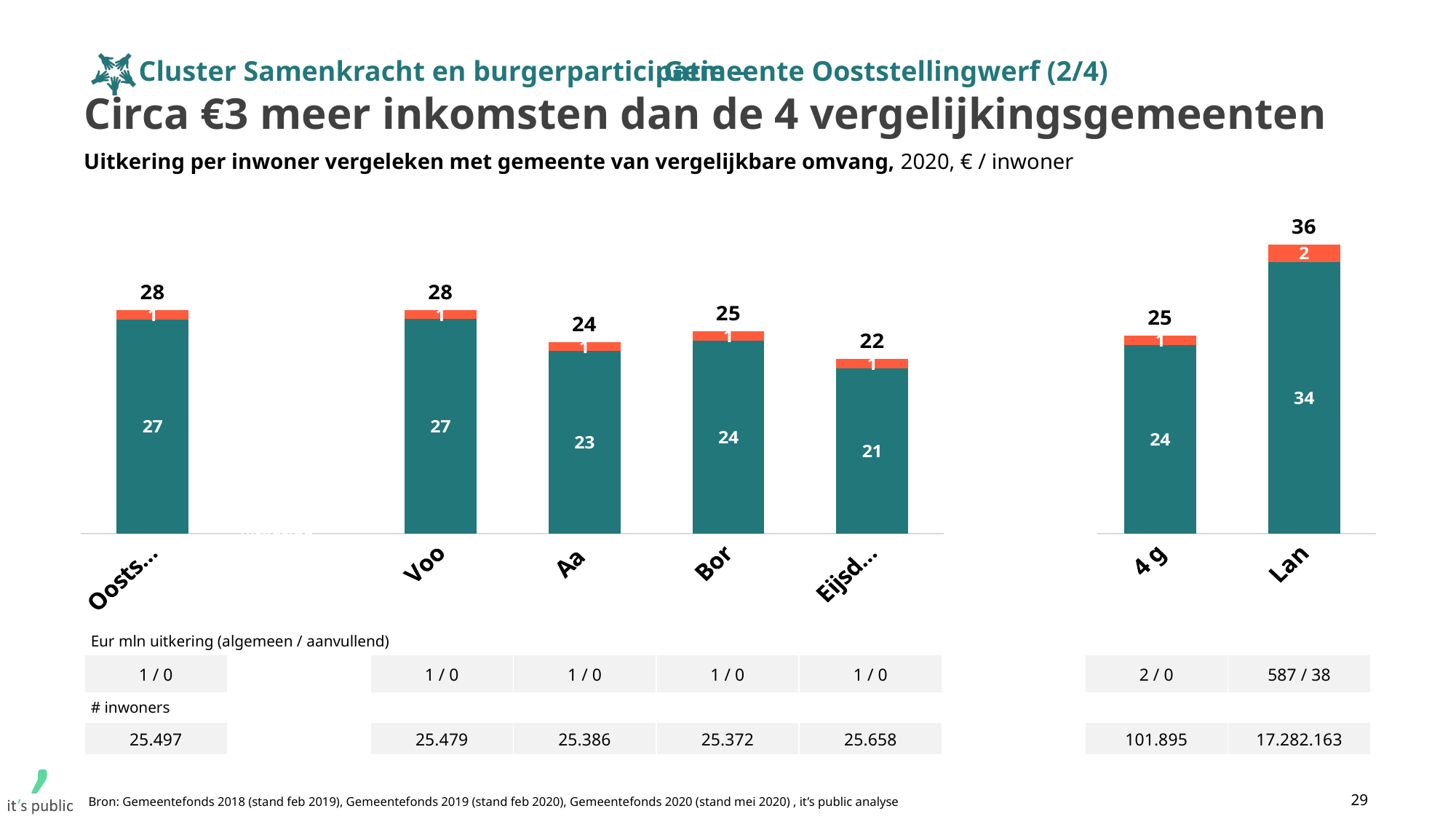
What is the total value shown above the bar for "Eijsd..."? 22 What kind of chart is shown on the slide? Stacked bar chart What is the total value shown above the bar for "Lan"? 36 Which category has the lowest total value? Eijsd... What is the difference between the total for "Lan" and the total for "Oosts..."? 8 Which category has the highest total value? Lan What is the total of the stacked bar for "4 g" (teal 24 plus orange 1)? 25 What unit is stated in the chart subtitle for the values plotted? € / inwoner Which has a larger total value, "Bor" or "Aa"? Bor What is the value of the orange (upper) segment of the bar for "Lan"? 2 What is the value of the teal (lower) segment of the bar for "Aa"? 23 How many bars are shown in the chart? 7